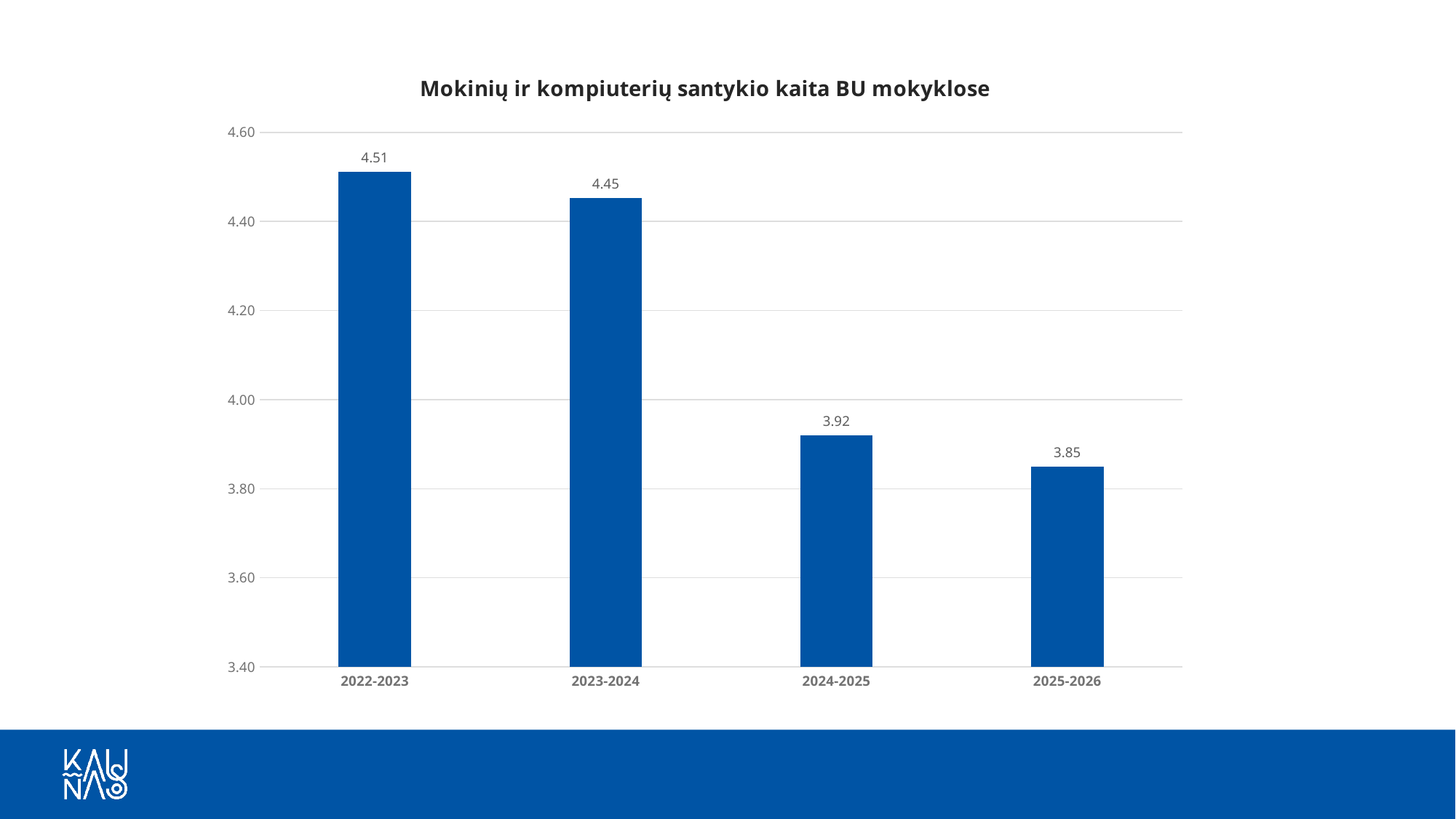
What kind of chart is shown on the slide? bar chart What is the difference between the values for 2022-2023 and 2025-2026? 0.66 How many school years are shown on the chart? 4 What is the difference between the values for 2023-2024 and 2024-2025? 0.53 Do the values rise or fall from 2022-2023 to 2025-2026? fall What is the value for 2025-2026? 3.85 Which school year has the highest value? 2022-2023 Is the value for 2024-2025 greater or less than 4.00? less Which school year has the lowest value? 2025-2026 What is the value for 2022-2023? 4.51 What is the value for 2024-2025? 3.92 Which is larger, the value for 2023-2024 or the value for 2024-2025? 2023-2024